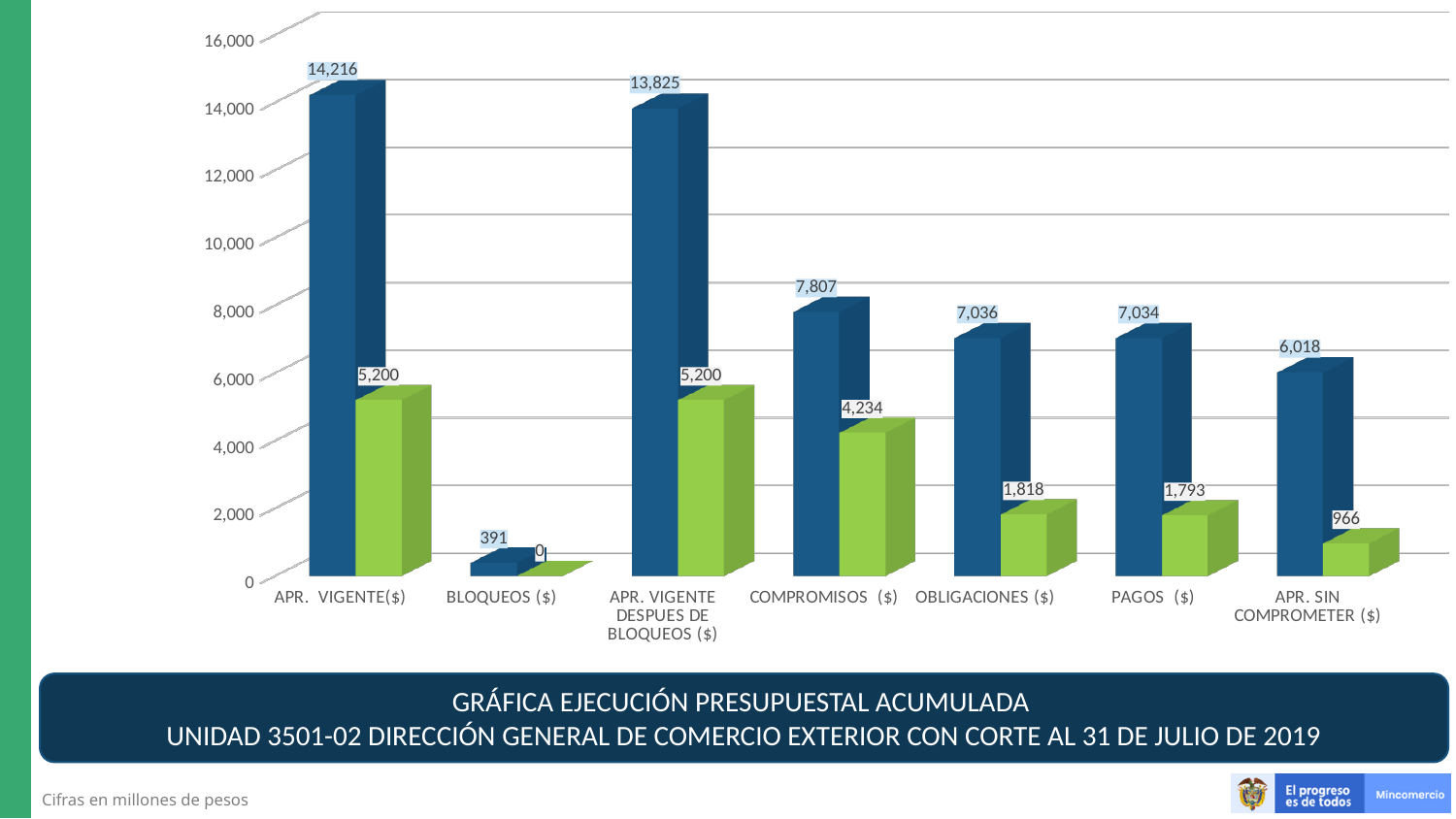
What is the difference between the blue and green bars for OBLIGACIONES ($)? 5,218 How many categories are shown on the x axis? 7 Which is larger, the blue bar for COMPROMISOS ($) or the blue bar for APR. SIN COMPROMETER ($)? COMPROMISOS ($) What unit are the figures in, according to the note at the bottom of the slide? millones de pesos What kind of chart is shown on the slide? bar chart Which category has the lowest green bar? BLOQUEOS ($) What is the difference between the blue bars for APR. VIGENTE($) and APR. VIGENTE DESPUES DE BLOQUEOS ($)? 391 What is the value of the blue bar for APR. VIGENTE($)? 14,216 What is the value of the green bar for COMPROMISOS ($)? 4,234 What is the value of the blue bar for BLOQUEOS ($)? 391 What is the value of the green bar for APR. SIN COMPROMETER ($)? 966 Which category has the highest blue bar? APR. VIGENTE($)